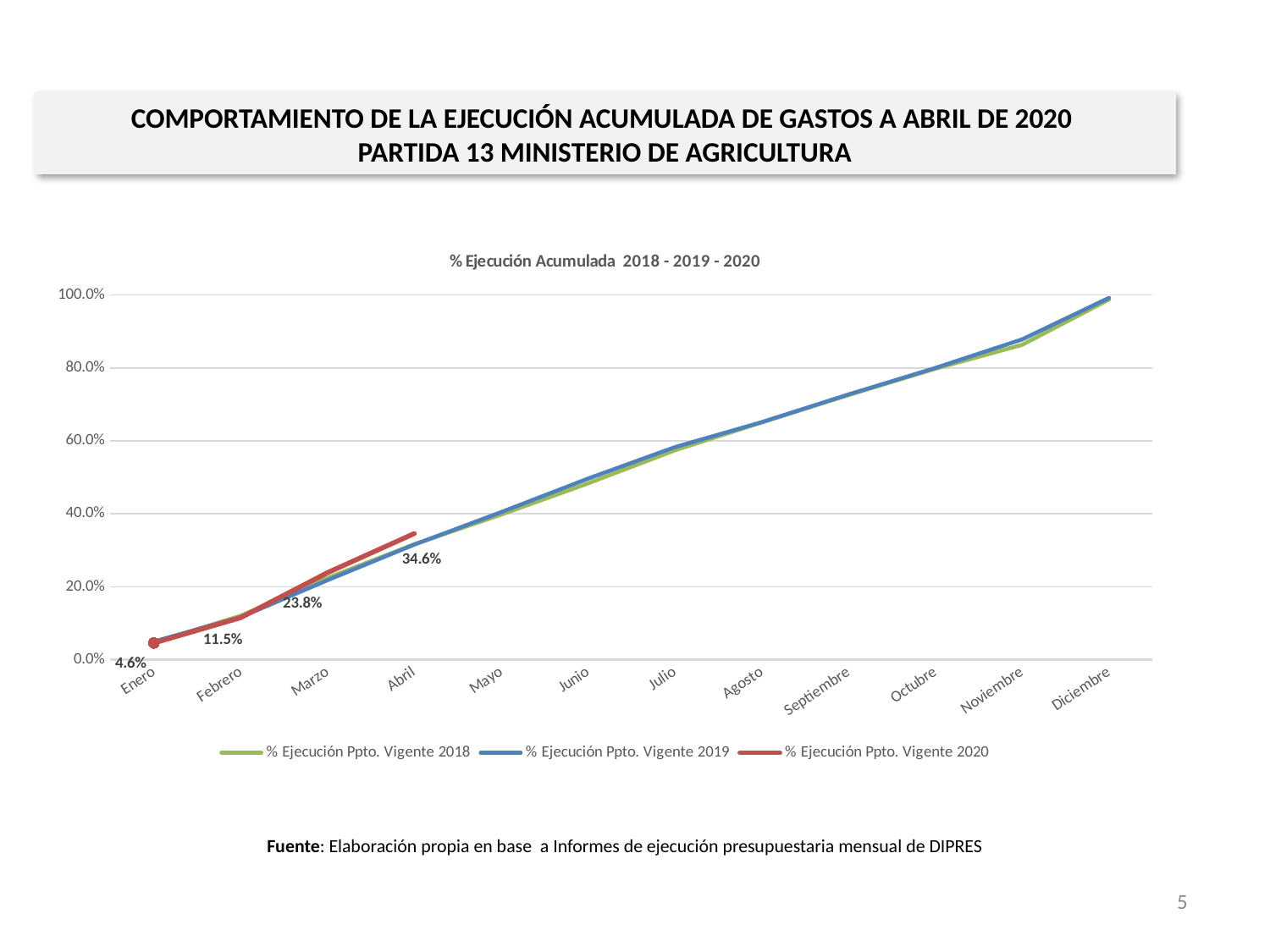
What is the value of % Ejecución Ppto. Vigente 2020 for Abril? 34.6% By how many percentage points did % Ejecución Ppto. Vigente 2020 increase from Marzo to Abril? 10.8 What is the value of % Ejecución Ppto. Vigente 2020 for Marzo? 23.8% What is the value of % Ejecución Ppto. Vigente 2020 for Enero? 4.6% What is the value of % Ejecución Ppto. Vigente 2020 for Febrero? 11.5% Do the values of % Ejecución Ppto. Vigente 2019 rise or fall from Enero to Diciembre? rise Which month has the highest value for % Ejecución Ppto. Vigente 2020? Abril What is the title of the chart? % Ejecución Acumulada 2018 - 2019 - 2020 Is the value for % Ejecución Ppto. Vigente 2019 in Diciembre greater or less than 80.0%? greater How many series does the chart legend list? 3 How many months are shown along the x axis of the chart? 12 What kind of chart is shown on the slide? line chart